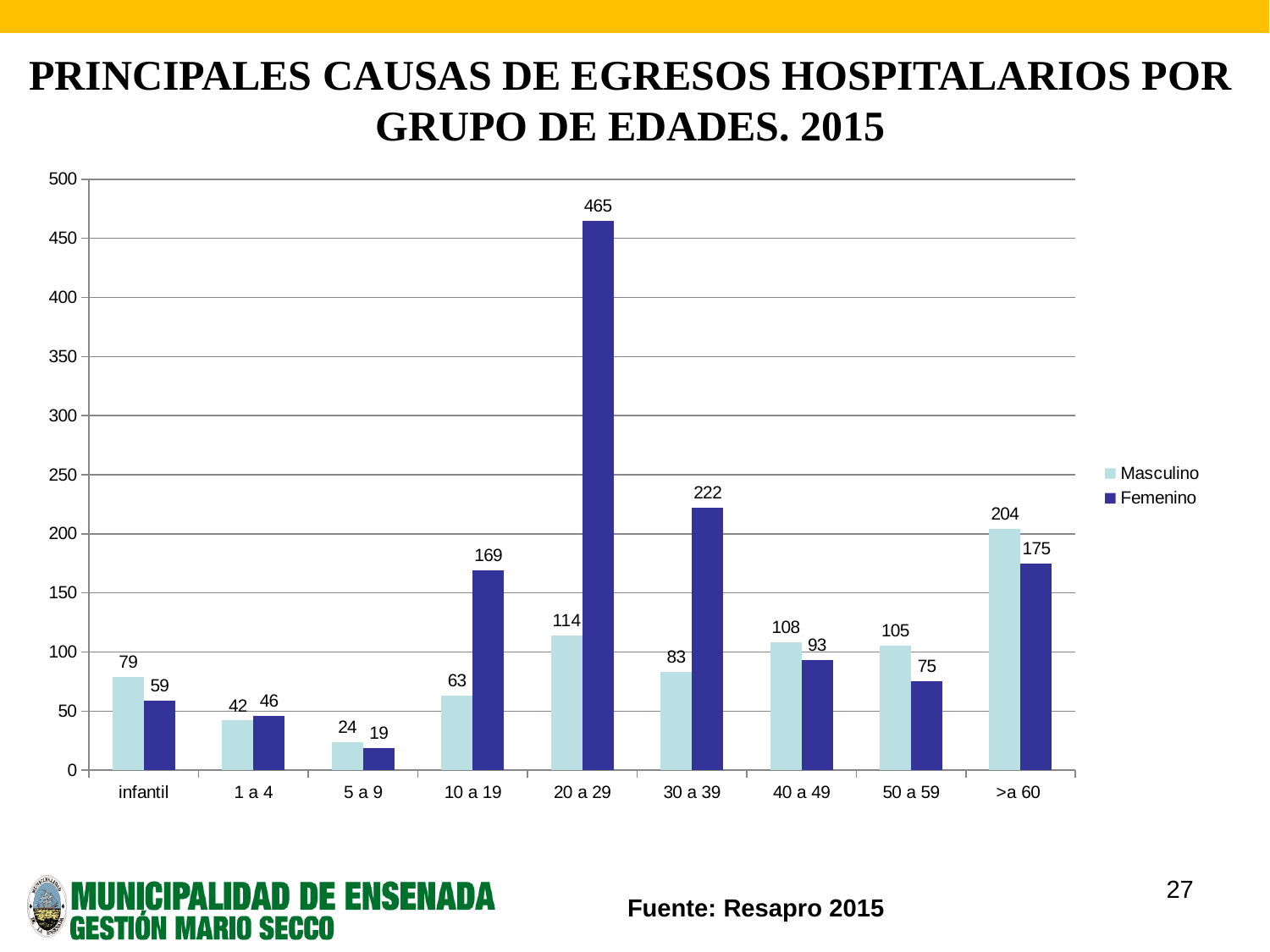
How many series does the legend list? 2 What is the Masculino value for the infantil group? 79 How many age groups are shown on the x axis? 9 What is the source cited below the chart? Resapro 2015 What kind of chart is shown on the slide? Bar chart Which age group has the highest Femenino value? 20 a 29 What is the Femenino value for the 20 a 29 age group? 465 What is the difference between the Femenino and Masculino values for the 30 a 39 age group? 139 What is the Masculino value for the >a 60 age group? 204 What is the combined Masculino and Femenino value for the 10 a 19 age group? 232 Which is larger for the 40 a 49 age group, Masculino or Femenino? Masculino Which age group has the lowest Masculino value? 5 a 9